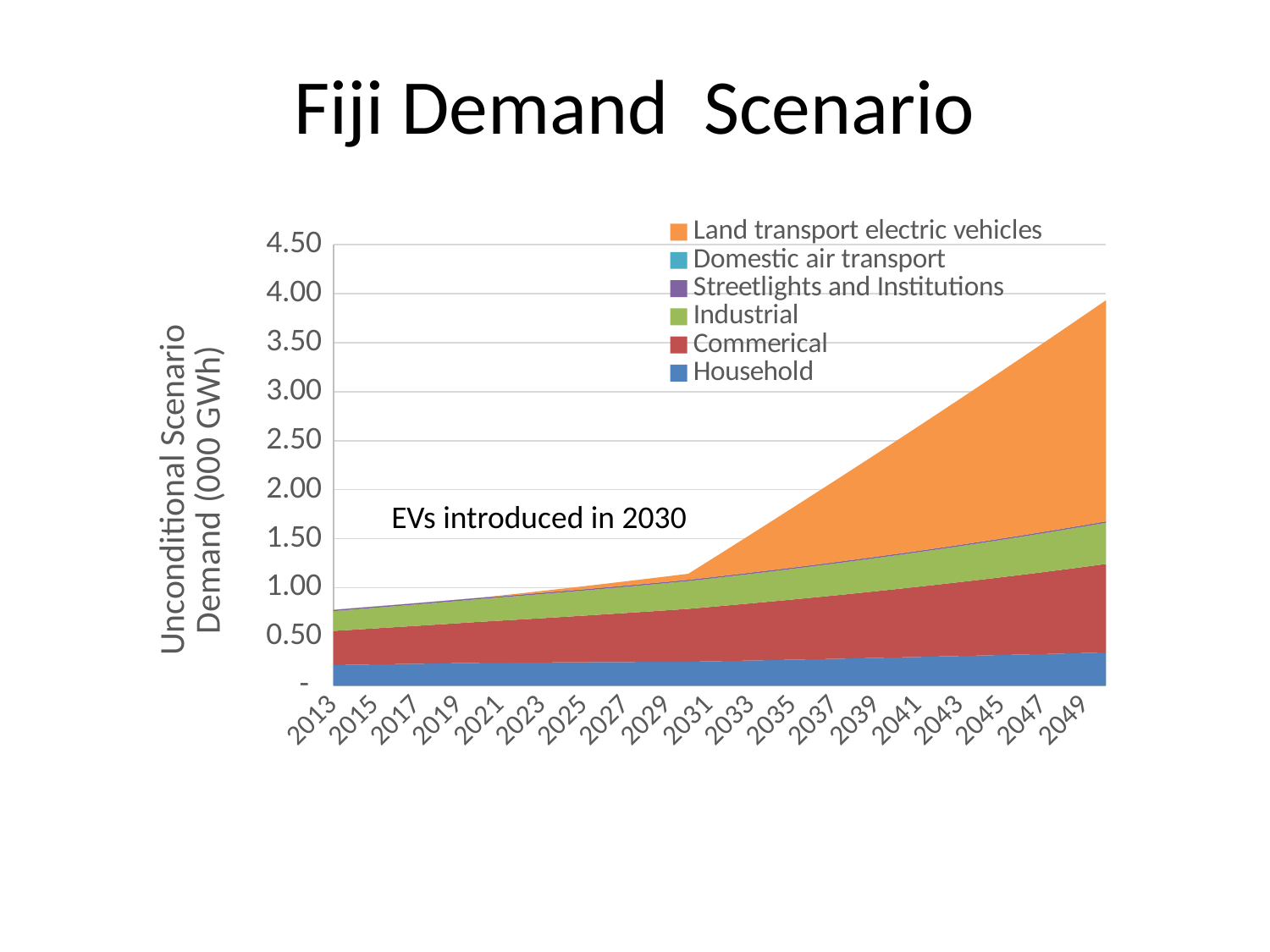
Is the total demand in 2029 greater or less than 1.50? less Is the total demand in 2013 greater or less than 1.00? less What is the label on the vertical axis? Unconditional Scenario Demand (000 GWh) What kind of chart is shown on the slide? Stacked area chart Does total demand rise or fall from 2013 to 2049? Rises Is the total demand in 2049 greater or less than 3.50? greater In 2049, which is larger: Commerical or Industrial demand? Commerical Which series contributes the most to total demand in 2049? Land transport electric vehicles How many series does the legend list? 6 How many year labels are shown on the x axis? 19 What is the title of the slide's chart? Fiji Demand Scenario